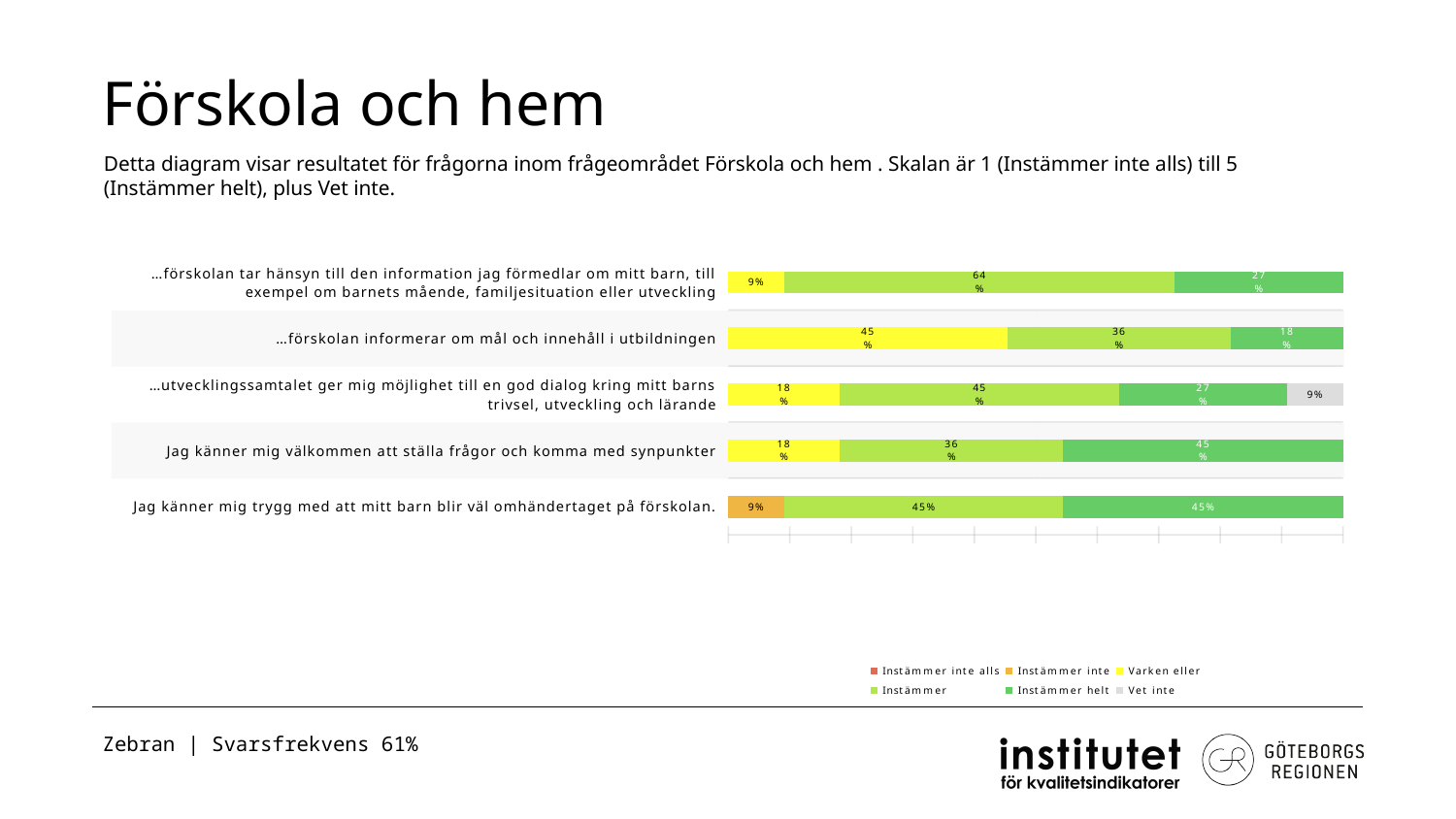
What kind of chart is shown on the slide? Stacked bar chart What is the 'Instämmer' share for '…förskolan tar hänsyn till den information jag förmedlar om mitt barn, till exempel om barnets mående, familjesituation eller utveckling'? 64% What is the 'Instämmer helt' share for 'Jag känner mig välkommen att ställa frågor och komma med synpunkter'? 45% What is the difference between the 'Instämmer' share (64%) and the 'Instämmer helt' share (27%) for '…förskolan tar hänsyn till den information jag förmedlar om mitt barn…'? 37% Which statement has the lowest 'Instämmer helt' share? …förskolan informerar om mål och innehåll i utbildningen What is the 'Instämmer inte' share for 'Jag känner mig trygg med att mitt barn blir väl omhändertaget på förskolan.'? 9% What is the 'Varken eller' share for '…förskolan informerar om mål och innehåll i utbildningen'? 45% Which is larger for '…förskolan informerar om mål och innehåll i utbildningen': the 'Varken eller' share or the 'Instämmer' share? Varken eller Which statement has the highest 'Instämmer' share? …förskolan tar hänsyn till den information jag förmedlar om mitt barn, till exempel om barnets mående, familjesituation eller utveckling What is the 'Vet inte' share for '…utvecklingssamtalet ger mig möjlighet till en god dialog kring mitt barns trivsel, utveckling och lärande'? 9% How many series does the legend list? 6 How many statements (categories) are plotted in the chart? 5